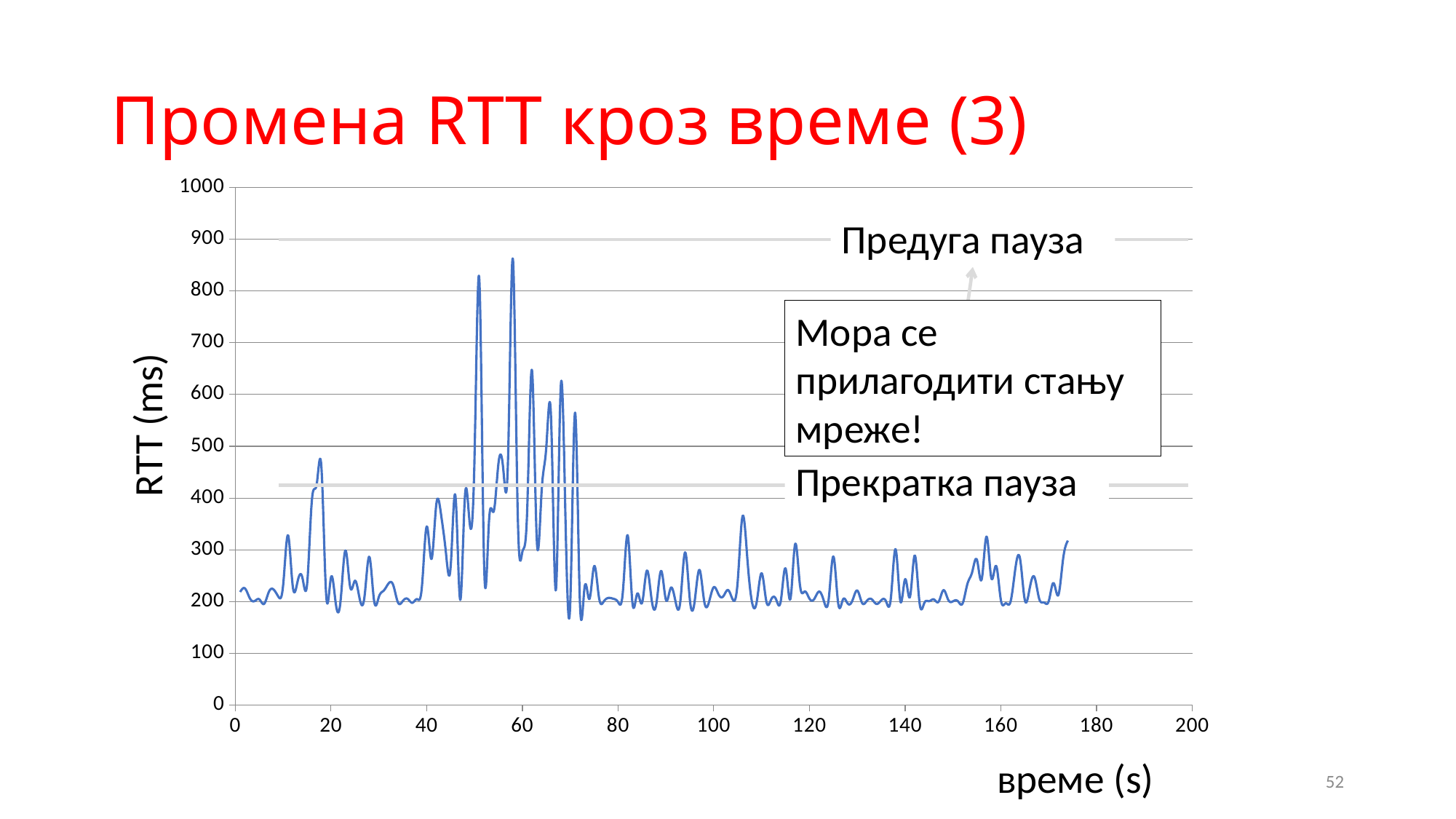
Is the highest RTT peak on the chart (near 58 s) greater or less than 900? less Is the lowest RTT value on the chart greater or less than 100? greater Is the RTT value at time 0 greater or less than 300? less Which is higher: the RTT peak near 58 s or the RTT peak near 62 s? the peak near 58 s What is the label of the vertical axis of the chart? RTT (ms) What kind of chart is shown on the slide? line chart What text labels the upper horizontal grey line on the chart? Предуга пауза